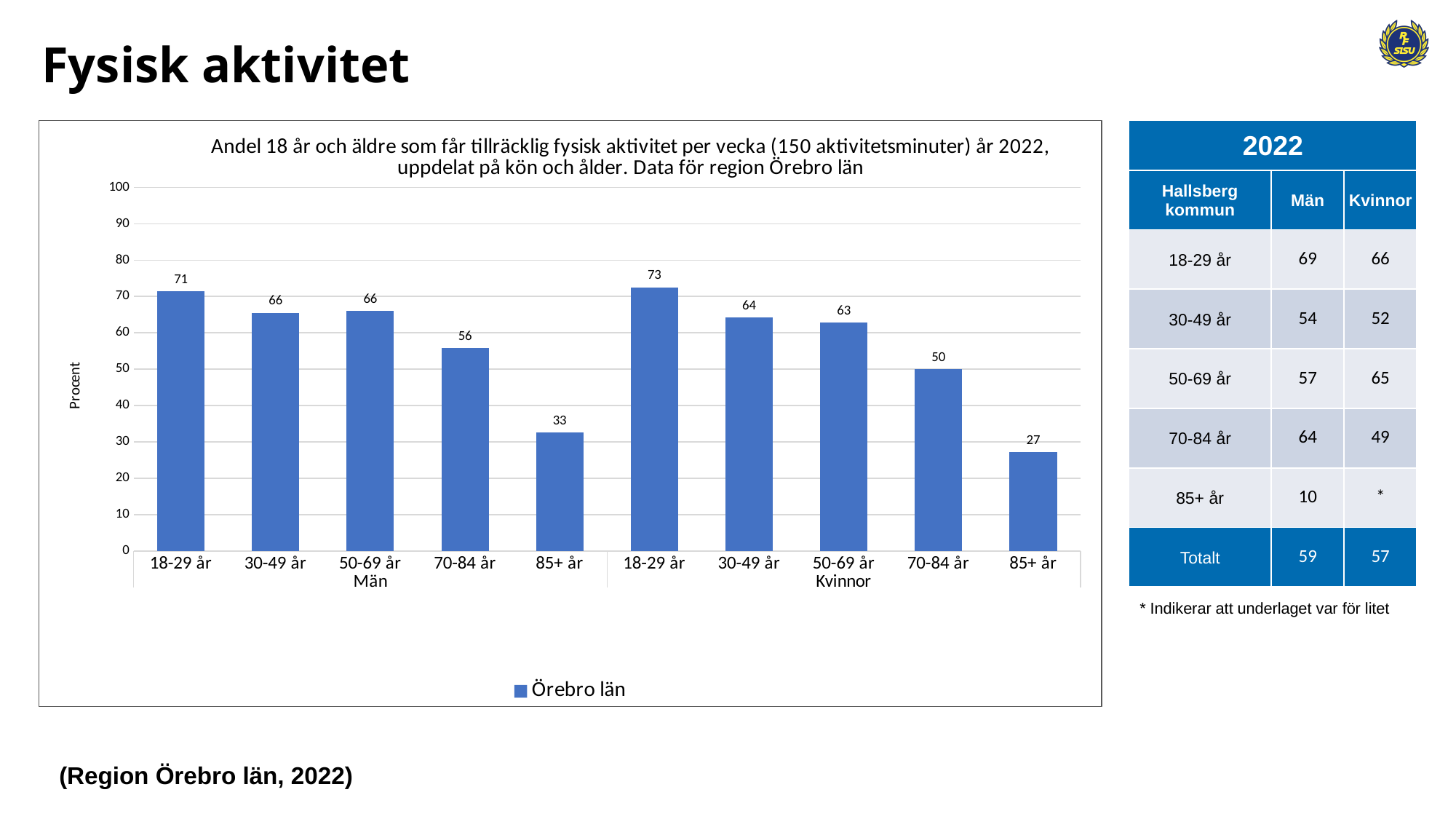
Which bar in the chart has the lowest value? Kvinnor 85+ år Is the value for women aged 50-69 år greater or less than 60? greater What is the difference between the values for men aged 18-29 år and men aged 85+ år? 38 How many bars are plotted in the chart? 10 What kind of chart is shown on the slide? Bar chart What is the value for women aged 85+ år in the chart? 27 Which bar in the chart has the highest value? Kvinnor 18-29 år What is the value for men aged 18-29 år in the chart? 71 Which is larger in the chart: the value for men aged 70-84 år or women aged 70-84 år? Män 70-84 år What is the label of the series in the chart legend? Örebro län What is the value for women aged 70-84 år in the chart? 50 How many series does the chart legend list? 1